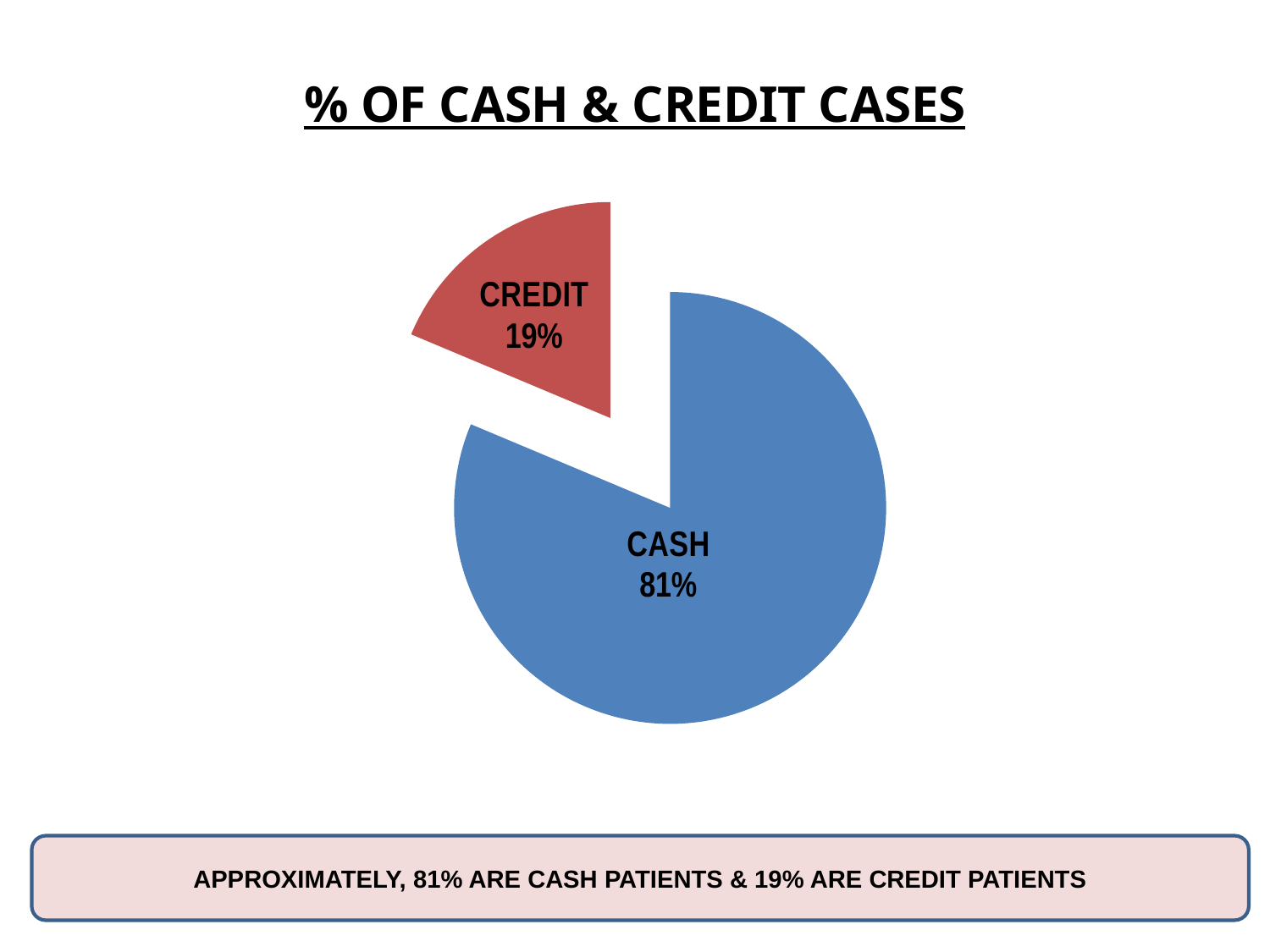
Which category has the largest share of the pie? CASH What is the difference in percentage points between the CASH and CREDIT slices? 62 What share of the pie does the CREDIT slice represent? 19% Which is larger, the CASH slice or the CREDIT slice? CASH What percentage of cases are CASH? 81% Which category has the smallest share of the pie? CREDIT How many slices does the pie chart have? 2 What is the total of the two slices shown? 100% What percentage of cases are CREDIT? 19% What colour is the CREDIT slice? Red What is the title of the chart? % OF CASH & CREDIT CASES What kind of chart is shown on the slide? Pie chart